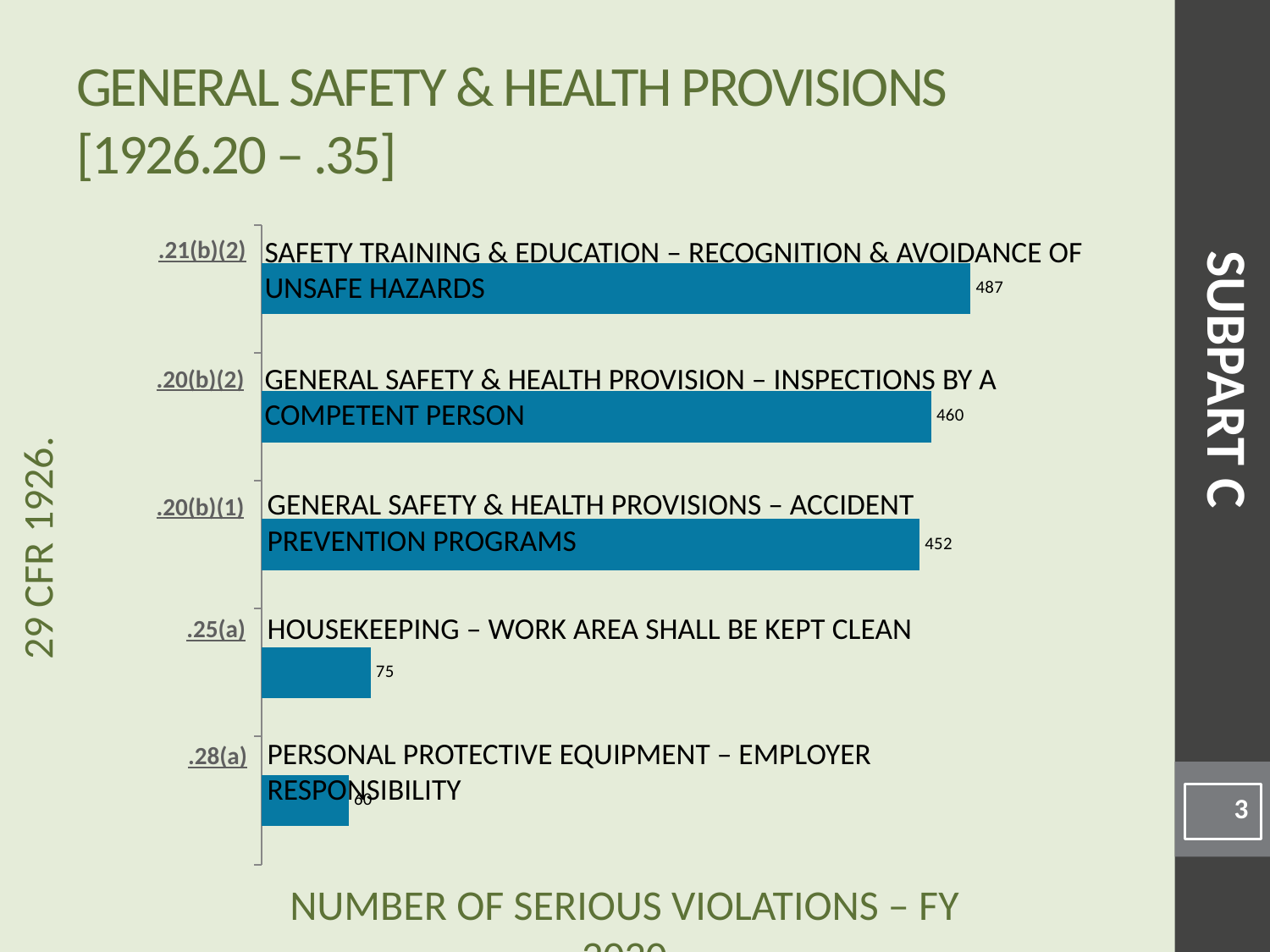
What is the difference between the values for .21(b)(2) and .20(b)(2)? 27 What is the number of serious violations for .20(b)(1) Accident Prevention Programs? 452 How many serious violations are shown for .21(b)(2) Safety Training & Education? 487 What is the value shown for .25(a) Housekeeping – Work Area Shall Be Kept Clean? 75 Which has more serious violations, .20(b)(2) or .20(b)(1)? .20(b)(2) Which standard has the lowest number of serious violations? .28(a) What colour are the bars in the chart? Blue What is the value for .20(b)(2) General Safety & Health Provision – Inspections by a Competent Person? 460 How much larger is the value for .20(b)(1) than the value for .25(a)? 377 Which standard has the highest number of serious violations? .21(b)(2) What type of chart is shown on the slide? Bar chart How many standards (bars) are shown in the chart? 5